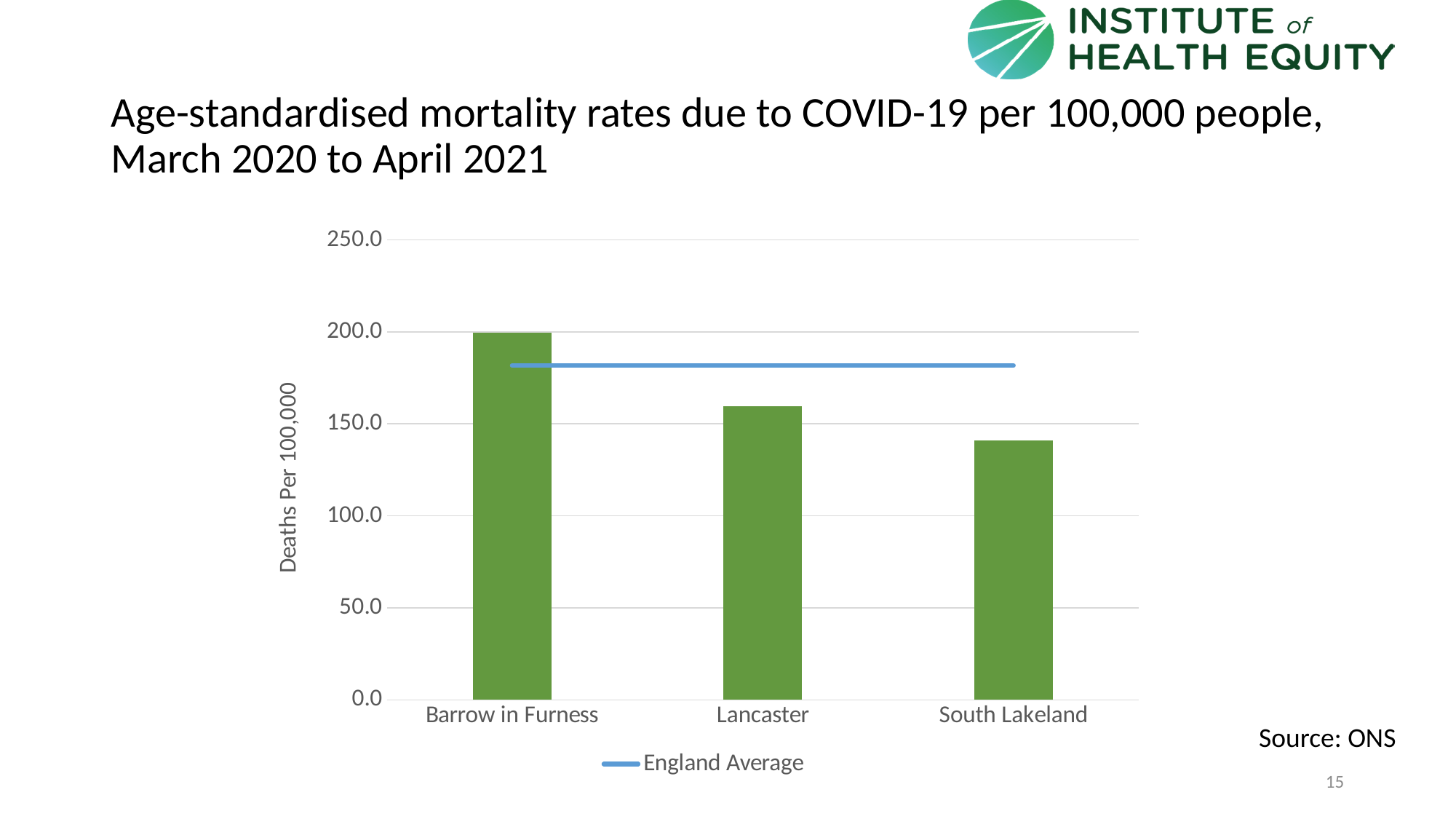
Which area has the highest age-standardised COVID-19 mortality rate? Barrow in Furness What entry does the chart legend list? England Average Is the value for Lancaster greater or less than 150.0? greater What is the label on the vertical axis of the chart? Deaths Per 100,000 What kind of chart is shown on the slide? bar chart Is the England Average line greater or less than 150.0? greater Do the bar values rise or fall from left to right across the chart? fall Which area has the lowest age-standardised COVID-19 mortality rate? South Lakeland Which has the higher mortality rate, Lancaster or South Lakeland? Lancaster Is the value for South Lakeland greater or less than 150.0? less How many local areas are plotted as bars on the chart? 3